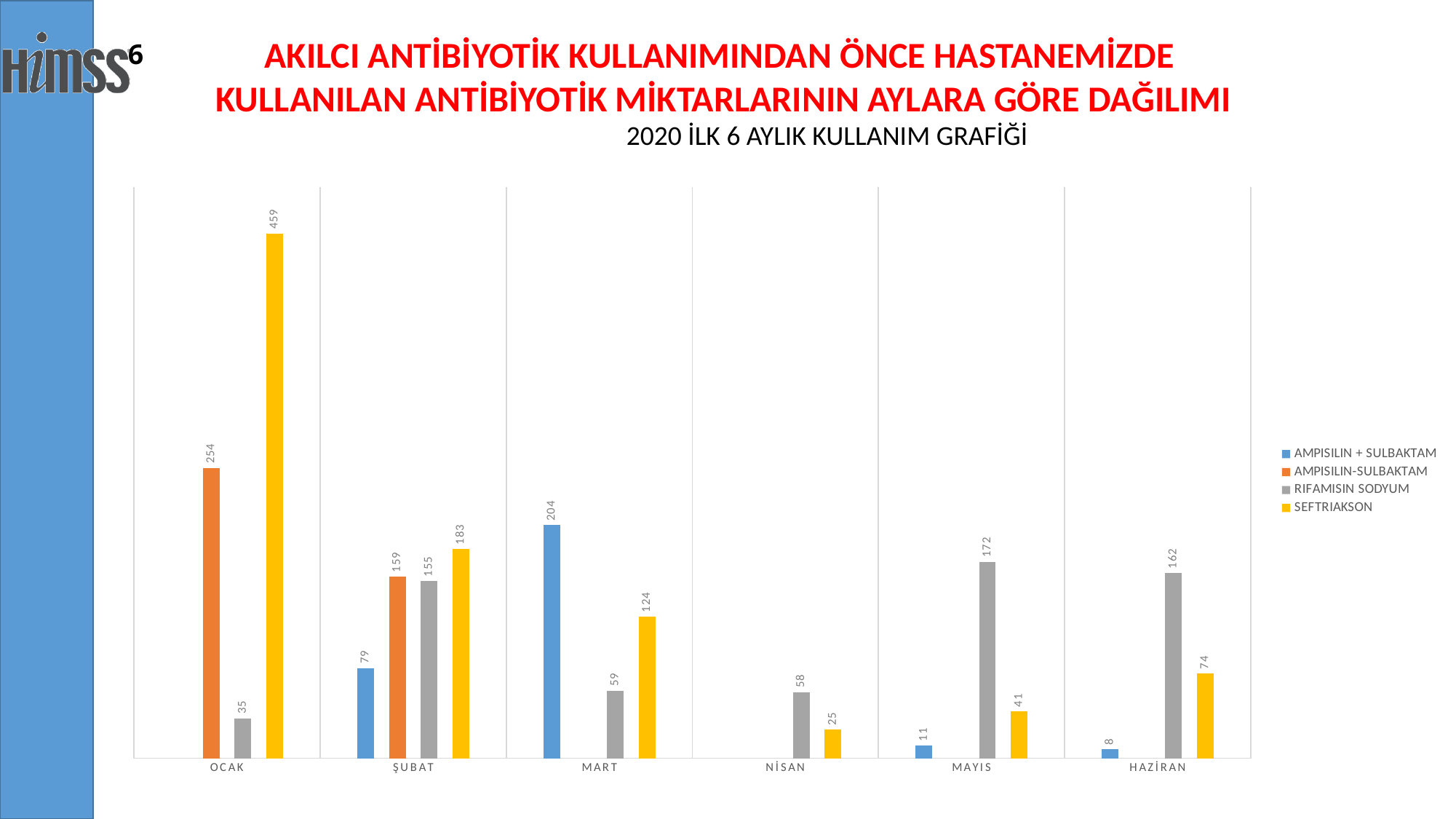
How many series does the legend list? 4 What is the value for RIFAMISIN SODYUM in MAYIS? 172 In which month is the SEFTRIAKSON value lowest? NİSAN Does the AMPISILIN + SULBAKTAM value rise or fall from MART to HAZİRAN? Fall What is the difference between the SEFTRIAKSON value in OCAK and in ŞUBAT? 276 What is the value for AMPISILIN + SULBAKTAM in MART? 204 How many months are shown on the x axis? 6 Which is larger in HAZİRAN: RIFAMISIN SODYUM or SEFTRIAKSON? RIFAMISIN SODYUM What kind of chart is shown on the slide? Bar chart What is the value for AMPISILIN-SULBAKTAM in ŞUBAT? 159 What is the value for SEFTRIAKSON in OCAK? 459 In which month is the SEFTRIAKSON value highest? OCAK